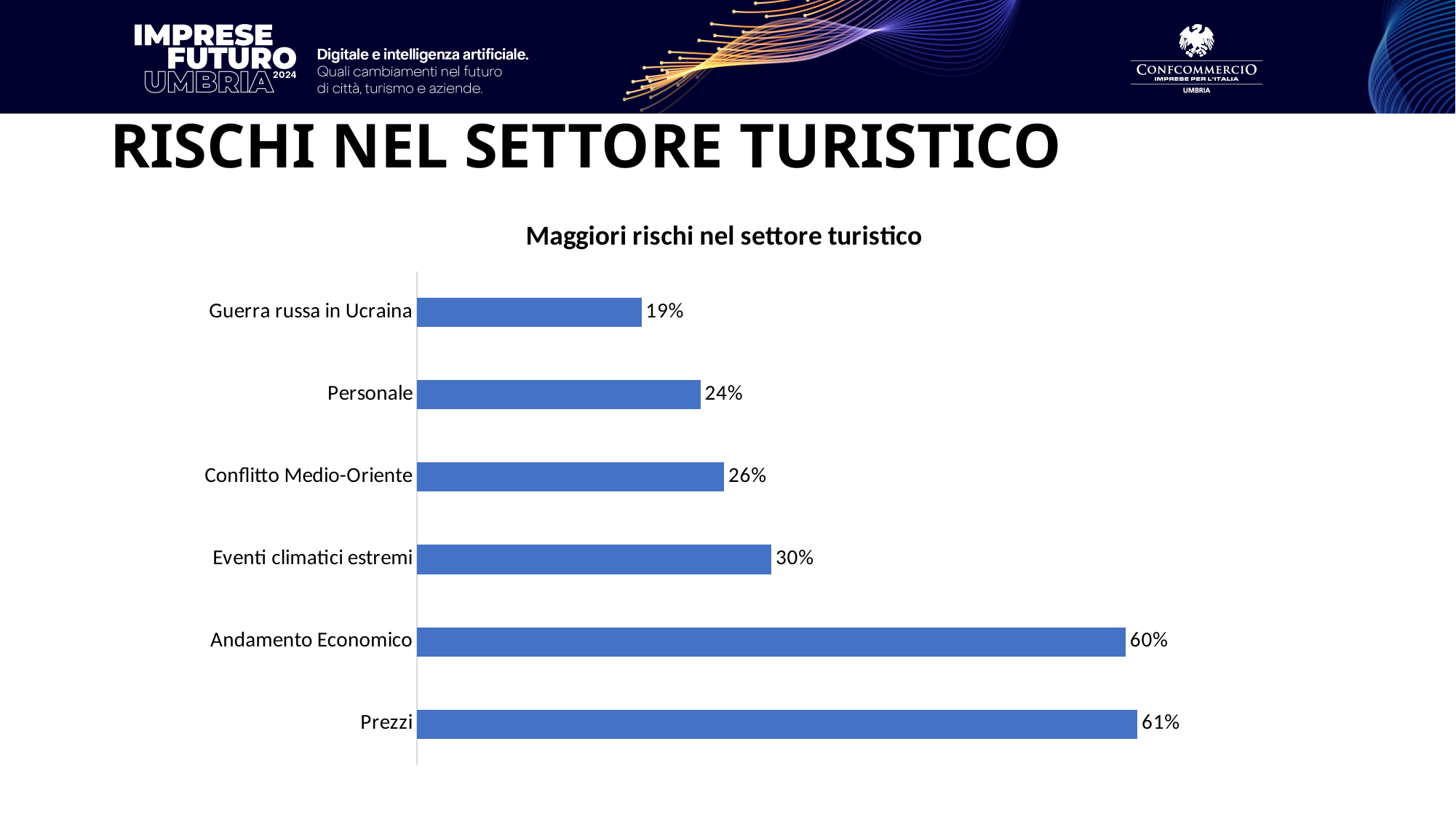
What is the value for Guerra russa in Ucraina? 19% Which category has the lowest value? Guerra russa in Ucraina How many categories are shown in the chart? 6 What kind of chart is shown on the slide? Bar chart What is the value for Eventi climatici estremi? 30% Which is larger, the value for Eventi climatici estremi or the value for Personale? Eventi climatici estremi Which category has the highest value? Prezzi What is the title of the chart? Maggiori rischi nel settore turistico What is the difference between the values for Conflitto Medio-Oriente and Personale? 2% What is the value for Prezzi? 61% What is the difference between the values for Prezzi and Eventi climatici estremi? 31% What is the value for Andamento Economico? 60%